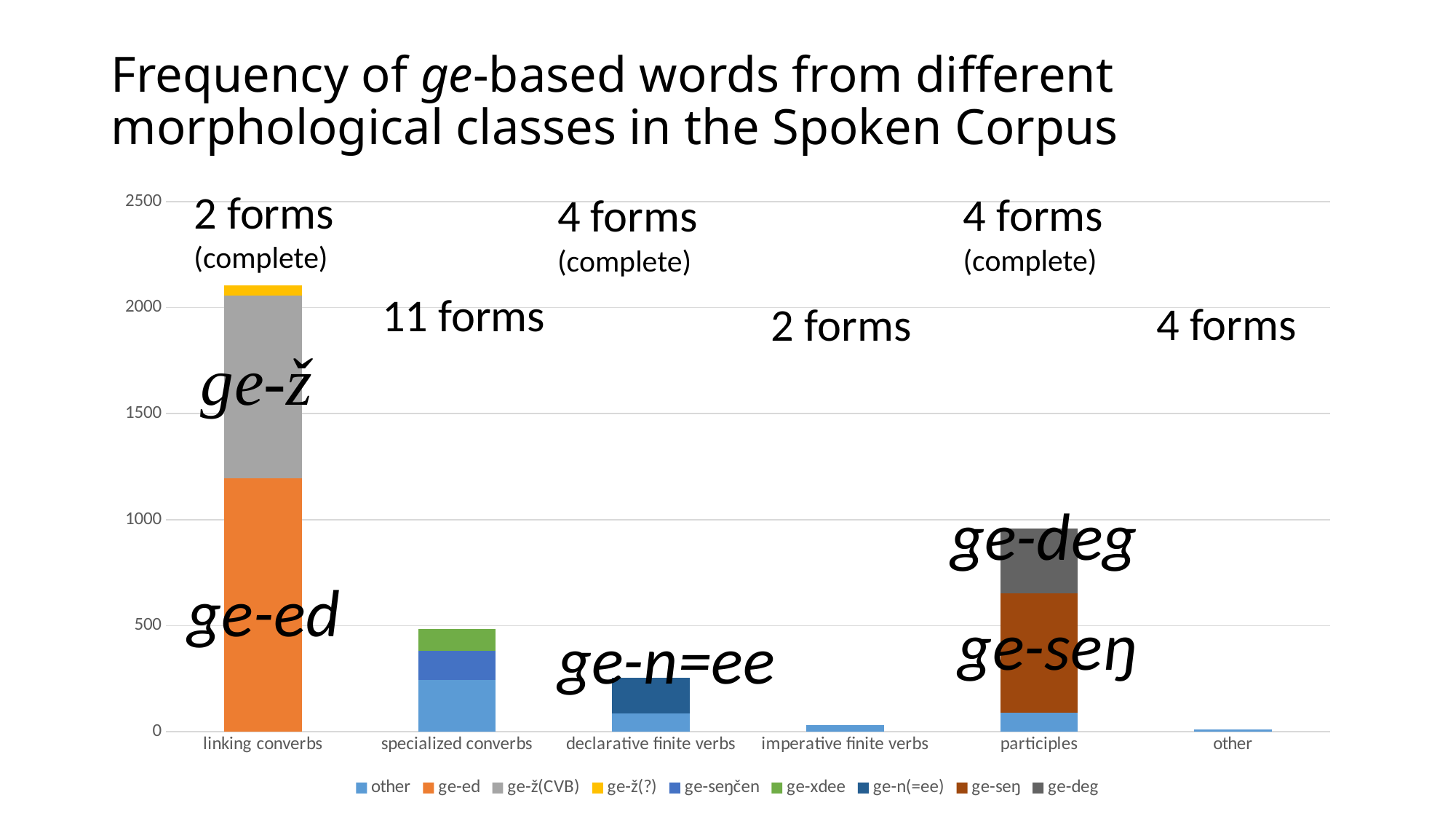
According to the annotation above the bar, how many forms are in the specialized converbs class? 11 forms Which series is shown in orange in the legend? ge-ed Is the total value for participles greater or less than 1000? less Is the total value for declarative finite verbs greater or less than 500? less What kind of chart is shown on the slide? stacked bar chart Is the total value for linking converbs greater or less than 2000? greater Which morphological class has the highest total frequency? linking converbs Which has a larger total frequency, linking converbs or participles? linking converbs Which has a larger total frequency, specialized converbs or declarative finite verbs? specialized converbs How many series does the legend list? 9 How many morphological classes (categories) are shown on the x axis? 6